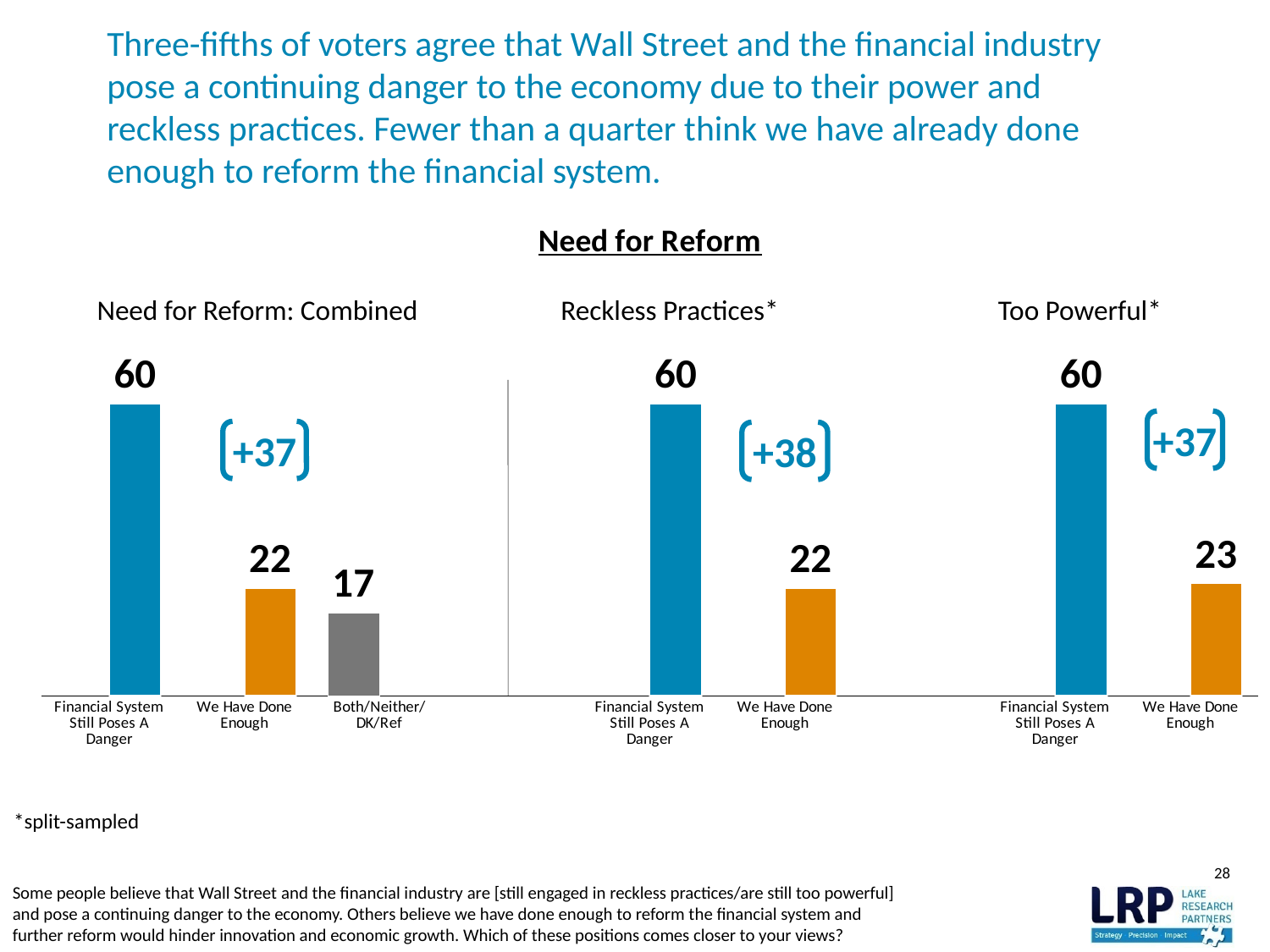
In the 'Too Powerful*' chart, which is larger: 'Financial System Still Poses A Danger' or 'We Have Done Enough'? Financial System Still Poses A Danger In the 'Too Powerful*' chart, what is the value for 'We Have Done Enough'? 23 In the 'Need for Reform: Combined' chart, what is the difference between 'We Have Done Enough' and 'Both/Neither/DK/Ref'? 5 In the 'Reckless Practices*' chart, what is the difference between 'Financial System Still Poses A Danger' and 'We Have Done Enough'? 38 In the 'Reckless Practices*' chart, what is the value for 'We Have Done Enough'? 22 What type of chart is the 'Too Powerful*' chart? Bar chart In the 'Need for Reform: Combined' chart, what is the value for 'Financial System Still Poses A Danger'? 60 How many categories are shown in the 'Need for Reform: Combined' chart? 3 In the 'Need for Reform: Combined' chart, which category has the lowest value? Both/Neither/DK/Ref In the 'Need for Reform: Combined' chart, what is the value for 'Both/Neither/DK/Ref'? 17 How many categories are shown in the 'Reckless Practices*' chart? 2 In the 'Too Powerful*' chart, which category has the highest value? Financial System Still Poses A Danger